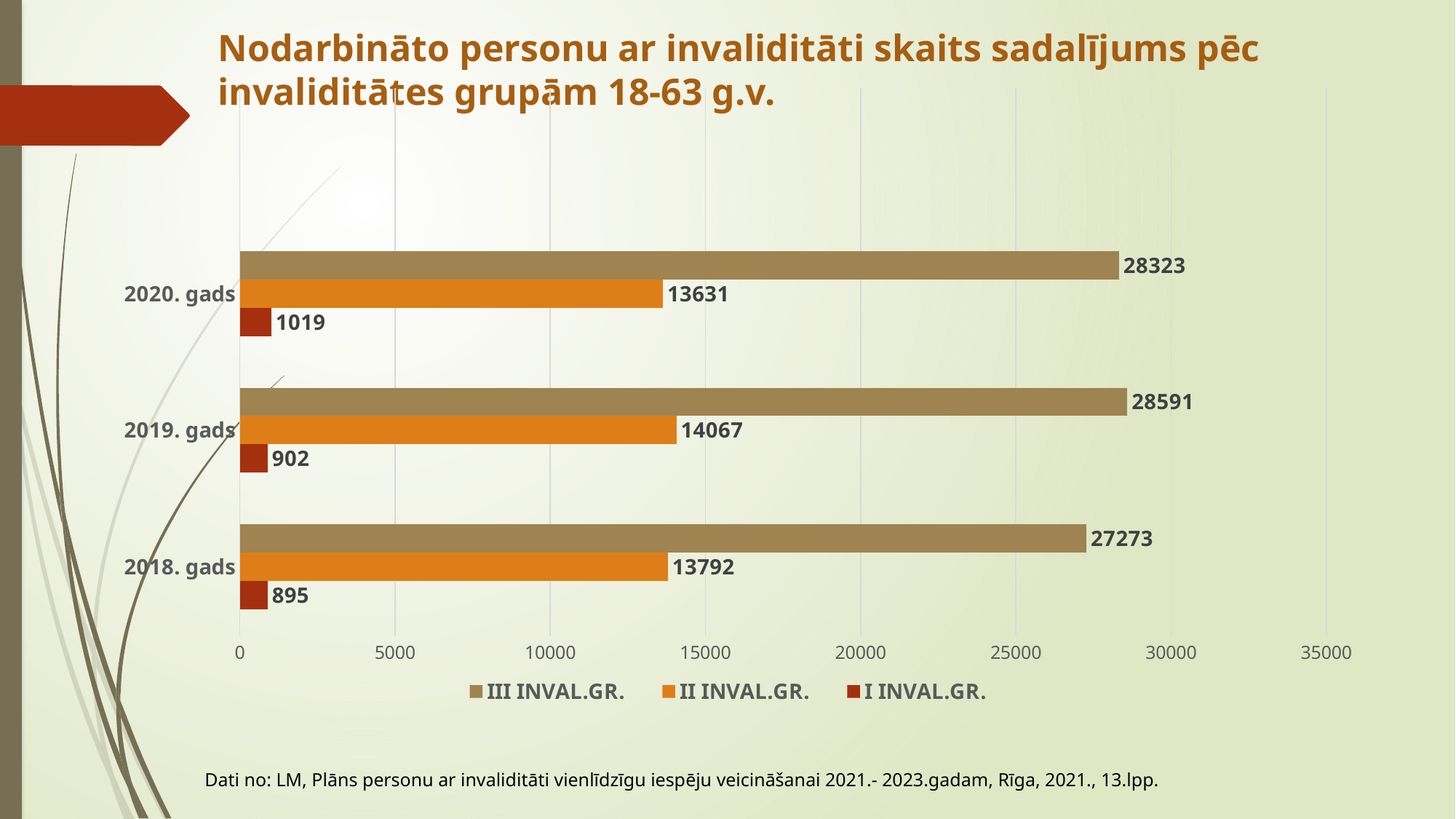
What is the total of the three groups for 2020. gads? 42973 What is the value for I INVAL.GR. in 2018. gads? 895 How many years are shown on the chart? 3 How many series does the legend list? 3 Which year has the lowest value for I INVAL.GR.? 2018. gads What is the value for III INVAL.GR. in 2020. gads? 28323 What is the value for II INVAL.GR. in 2019. gads? 14067 What kind of chart is shown on the slide? bar chart Which year has the highest value for III INVAL.GR.? 2019. gads Is the value for II INVAL.GR. in 2020. gads greater or less than 15000? less What is the difference between the III INVAL.GR. values for 2019. gads and 2018. gads? 1318 Which is larger: II INVAL.GR. in 2018. gads or II INVAL.GR. in 2020. gads? II INVAL.GR. in 2018. gads